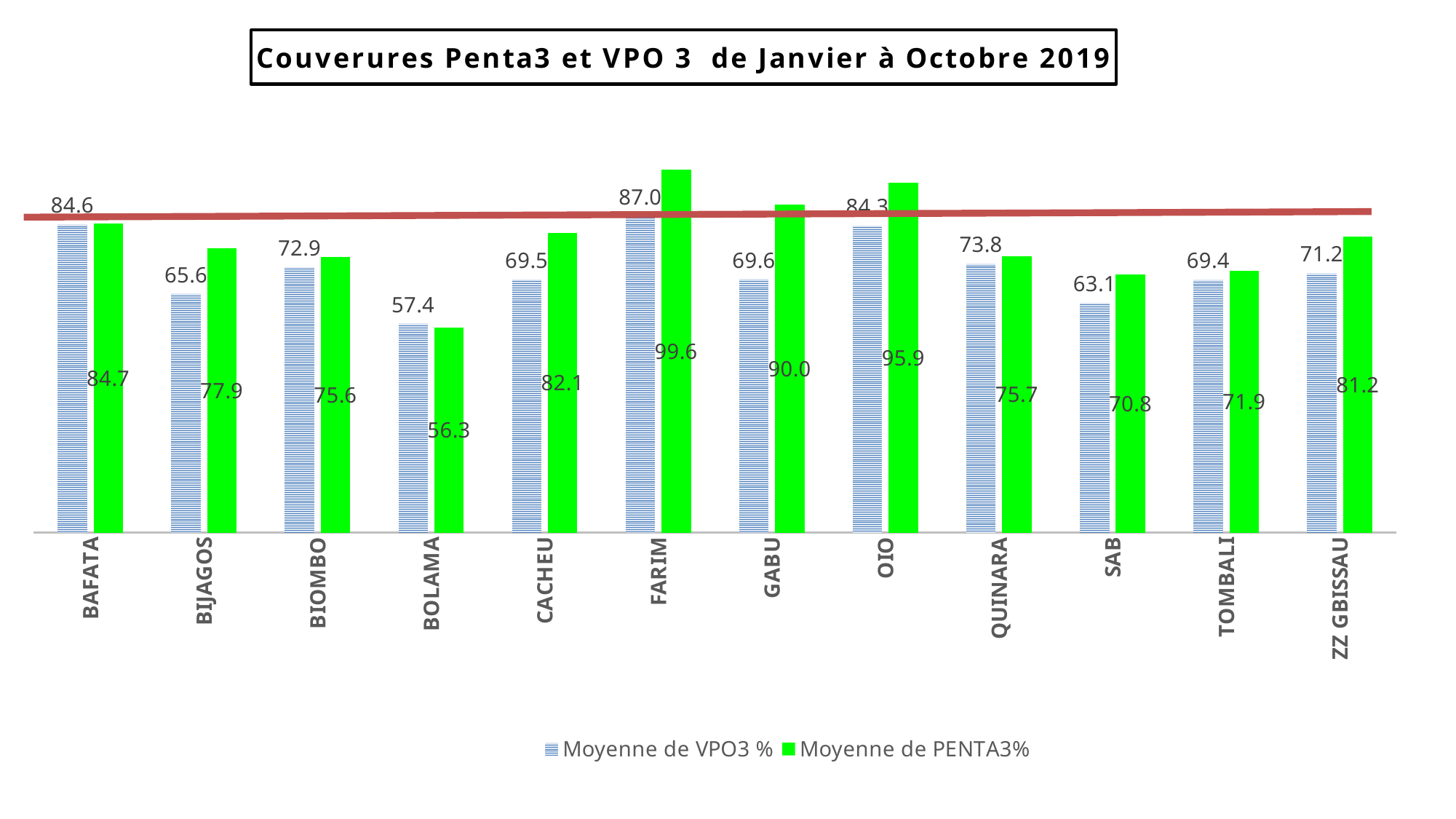
What is the difference between the Moyenne de PENTA3% and Moyenne de VPO3 % values for FARIM? 12.6 How many series does the legend list? 2 Which is larger: the Moyenne de PENTA3% value for OIO or for CACHEU? OIO What is the Moyenne de PENTA3% value for GABU? 90.0 Which region has the highest Moyenne de PENTA3% value? FARIM What is the difference between the Moyenne de PENTA3% and Moyenne de VPO3 % values for GABU? 20.4 How many regions are shown on the x axis of the chart? 12 For BOLAMA, which is larger: the Moyenne de VPO3 % value or the Moyenne de PENTA3% value? Moyenne de VPO3 % What is the Moyenne de PENTA3% value for FARIM? 99.6 Which region has the lowest Moyenne de VPO3 % value? BOLAMA What is the Moyenne de VPO3 % value for BIJAGOS? 65.6 What kind of chart is shown on the slide? Bar chart